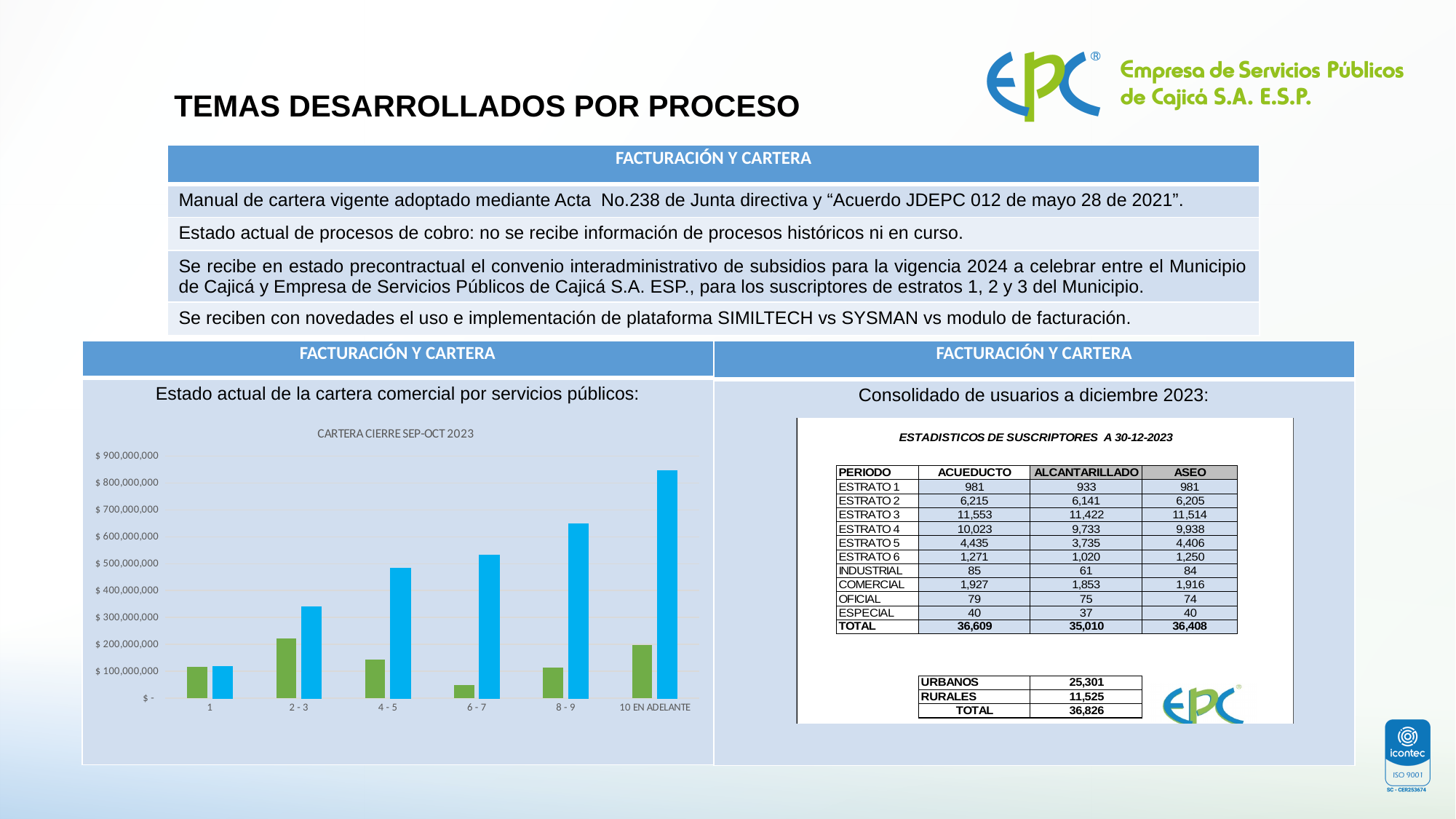
In the CARTERA CIERRE SEP-OCT 2023 chart, which category has the tallest blue bar? 10 EN ADELANTE In the CARTERA CIERRE SEP-OCT 2023 chart, is the green bar for 6 - 7 greater or less than $ 100,000,000? less What is the highest value labelled on the y axis of the CARTERA CIERRE SEP-OCT 2023 chart? $ 900,000,000 In the CARTERA CIERRE SEP-OCT 2023 chart, is the blue bar for 8 - 9 greater or less than $ 600,000,000? greater What is the title of the bar chart on the slide? CARTERA CIERRE SEP-OCT 2023 How many categories are shown on the x axis of the CARTERA CIERRE SEP-OCT 2023 chart? 6 What kind of chart is shown under "Estado actual de la cartera comercial por servicios públicos"? bar chart In the CARTERA CIERRE SEP-OCT 2023 chart, is the blue bar for 10 EN ADELANTE greater or less than $ 800,000,000? greater In the CARTERA CIERRE SEP-OCT 2023 chart, which is larger for category 4 - 5: the green bar or the blue bar? the blue bar In the CARTERA CIERRE SEP-OCT 2023 chart, do the blue bars generally rise or fall from category 1 to 10 EN ADELANTE? rise In the CARTERA CIERRE SEP-OCT 2023 chart, which category has the shortest green bar? 6 - 7